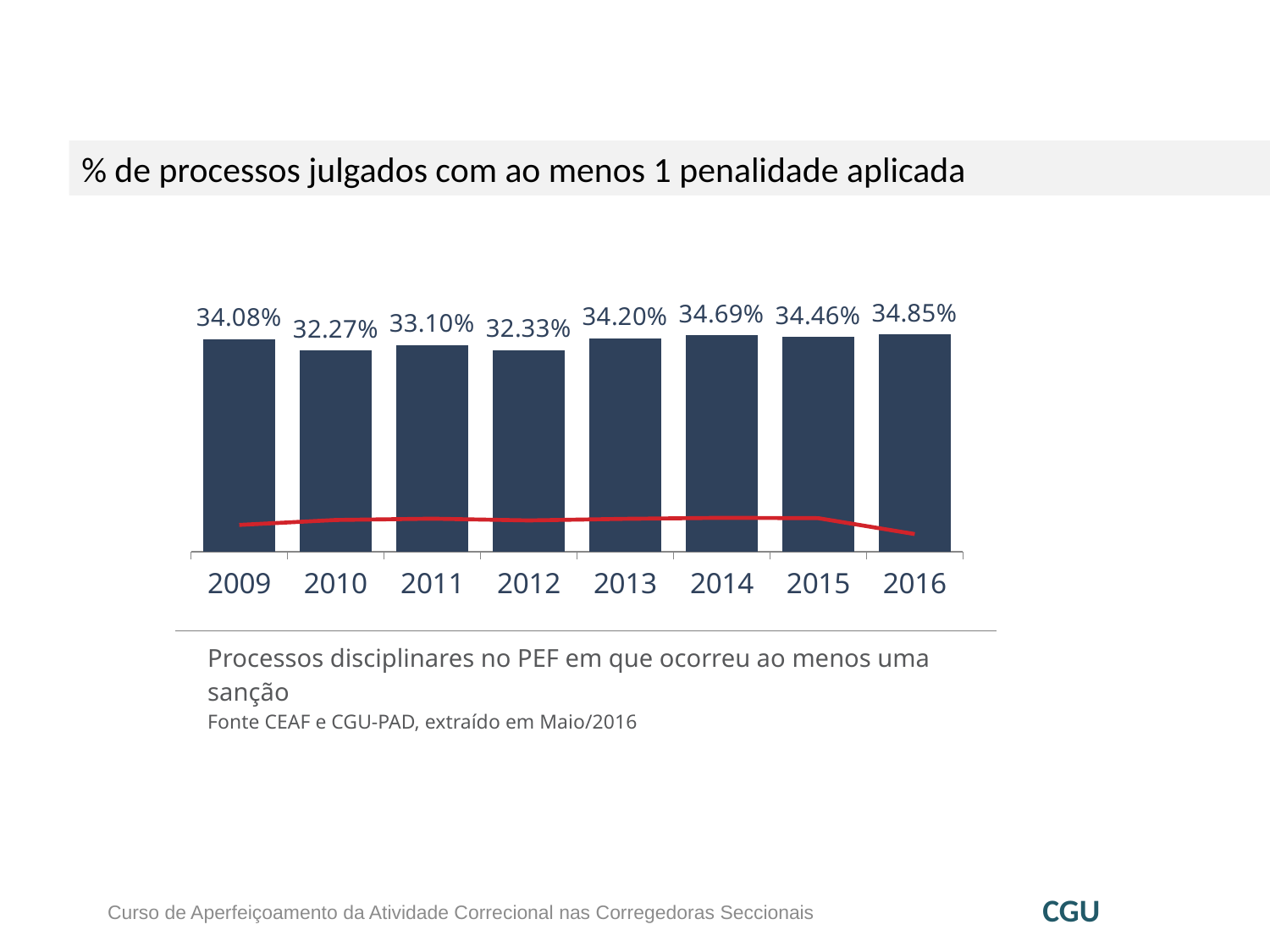
What is the value for 2009? 34.08% What is the difference between the values for 2016 and 2010? 2.58 percentage points Which is larger, the value for 2011 or the value for 2012? 2011 Which is larger, the value for 2009 or the value for 2010? 2009 Which year has the highest value? 2016 What is the value for 2016? 34.85% What kind of chart is this? Combination bar and line chart Which year has the lowest value? 2010 Do the values rise or fall from 2012 to 2014? Rise What is the value for 2013? 34.20% What is the difference between the values for 2014 and 2013? 0.49 percentage points How many years are shown on the x axis? 8